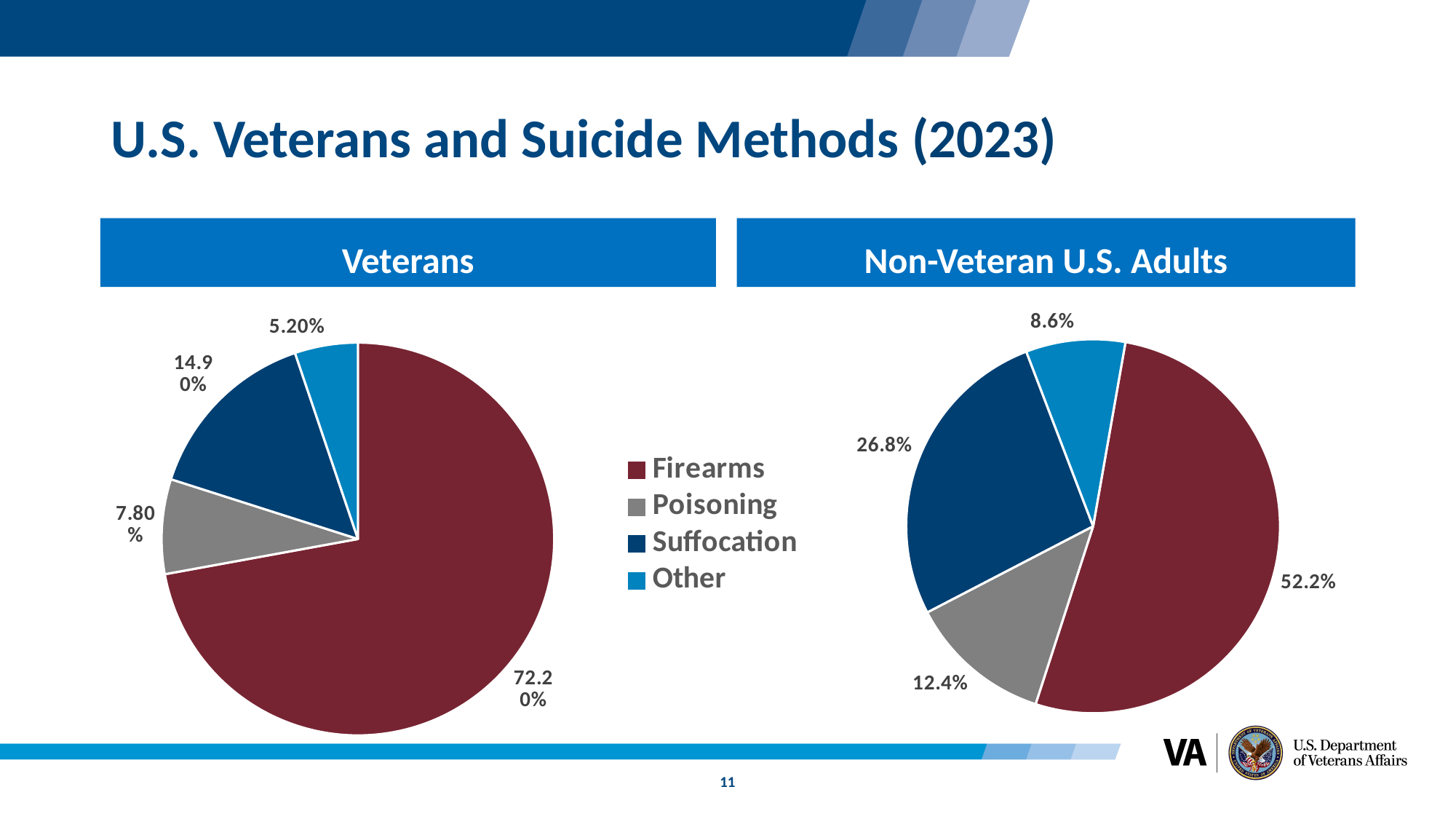
In the Veterans pie chart, what share is Firearms? 72.20% What is the difference between the Firearms share in the Veterans chart and the Firearms share in the Non-Veteran U.S. Adults chart? 20 percentage points Which colour represents Poisoning in the legend? Grey In the Non-Veteran U.S. Adults pie chart, what share is Suffocation? 26.8% In the Non-Veteran U.S. Adults pie chart, what share is Poisoning? 12.4% In the Non-Veteran U.S. Adults pie chart, which method has the smallest share? Other In the Veterans pie chart, what share is Other? 5.20% What type of chart is used for the Non-Veteran U.S. Adults data? Pie chart How many slices does the Veterans pie chart have? 4 In the Non-Veteran U.S. Adults pie chart, what is the difference between the Suffocation and Poisoning shares? 14.4 percentage points In the Veterans pie chart, which method has the largest share? Firearms Is the Suffocation share larger in the Veterans chart or in the Non-Veteran U.S. Adults chart? Non-Veteran U.S. Adults